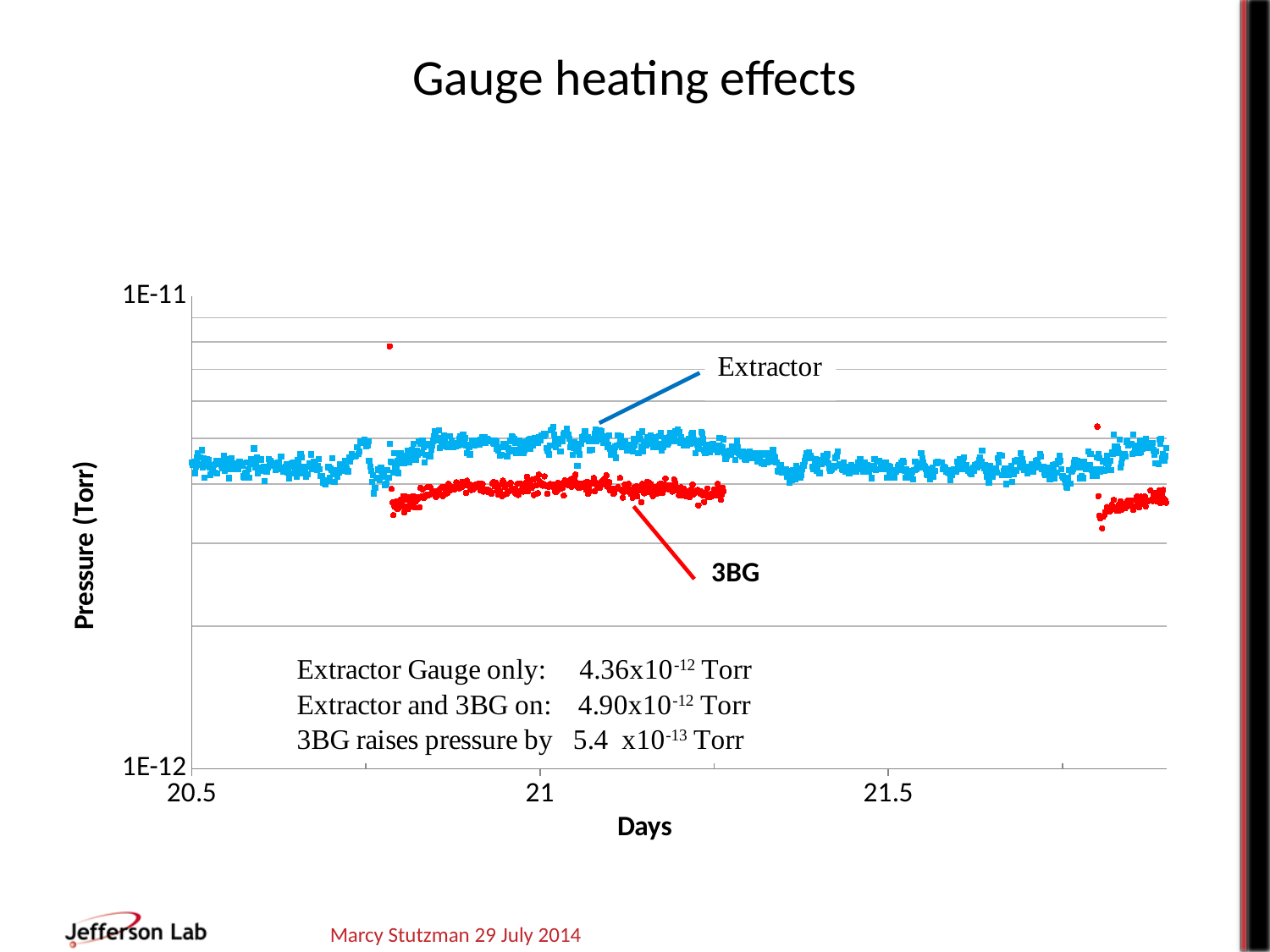
How many data series are plotted on the chart? 2 What kind of chart is shown on the slide? scatter chart Which series shows higher pressure values, Extractor or 3BG? Extractor According to the text on the chart, by how much does the 3BG raise the pressure? 5.4 x10^-13 Torr Is the pressure for the 3BG series greater or less than 1E-11 Torr? less According to the text on the chart, what is the pressure with the Extractor Gauge only? 4.36x10^-12 Torr Is the pressure for the Extractor series greater or less than 1E-12 Torr? greater What is the label of the x axis? Days According to the text on the chart, what is the pressure with the Extractor and 3BG on? 4.90x10^-12 Torr What is the title of the chart? Gauge heating effects What is the label of the y axis? Pressure (Torr)